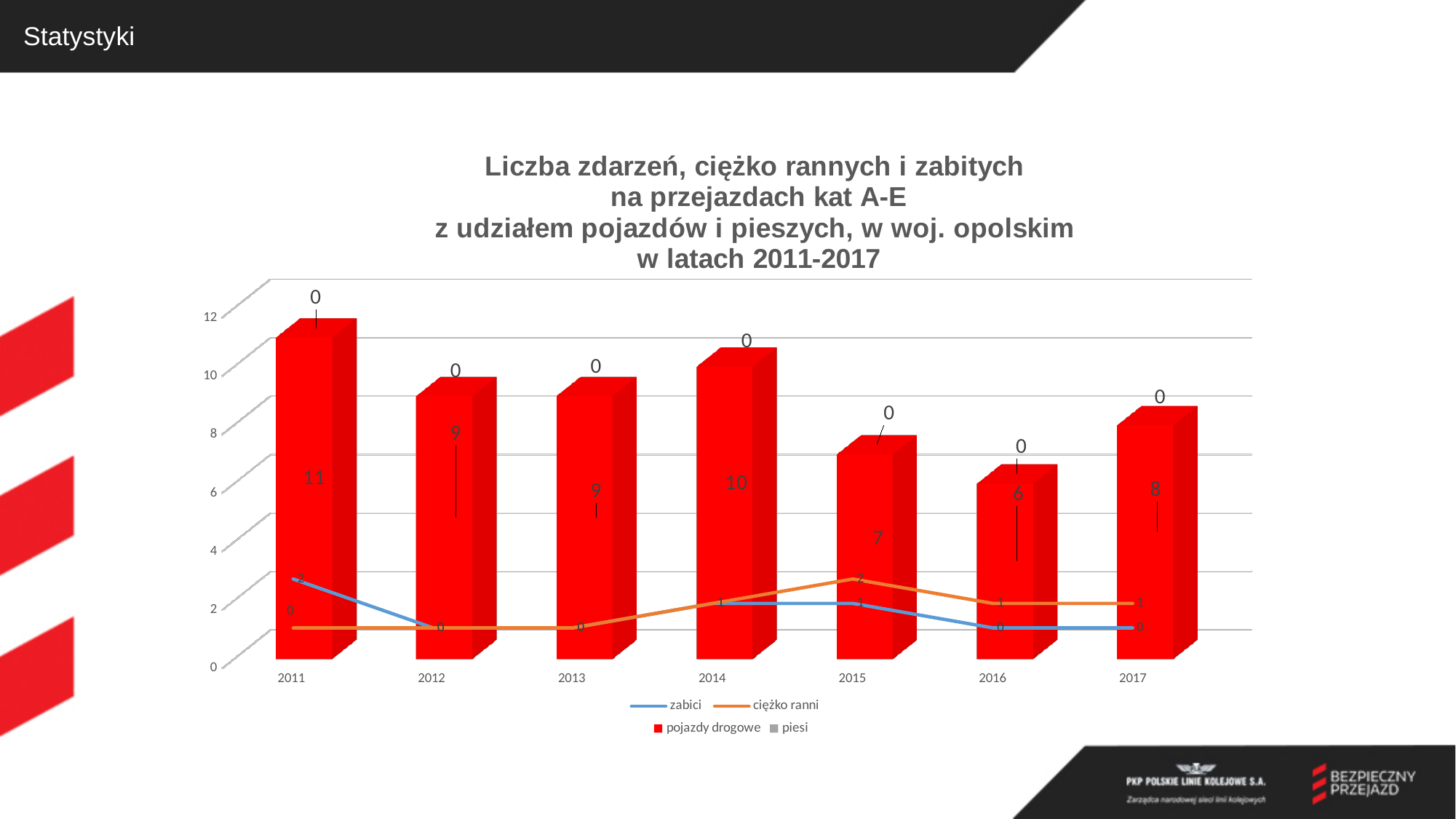
What is the difference between the pojazdy drogowe values for 2011 and 2016? 5 How many years are shown on the x axis? 7 Which series is drawn as red bars? pojazdy drogowe What is the value for pojazdy drogowe in 2011? 11 What is the value for piesi in 2013? 0 What is the value for zabici in 2011? 2 What is the value for ciężko ranni in 2015? 2 Which is larger, the pojazdy drogowe value for 2014 or for 2017? 2014 Which year has the lowest value for pojazdy drogowe? 2016 How many series does the legend list? 4 Which year has the highest value for pojazdy drogowe? 2011 What is the value for pojazdy drogowe in 2015? 7